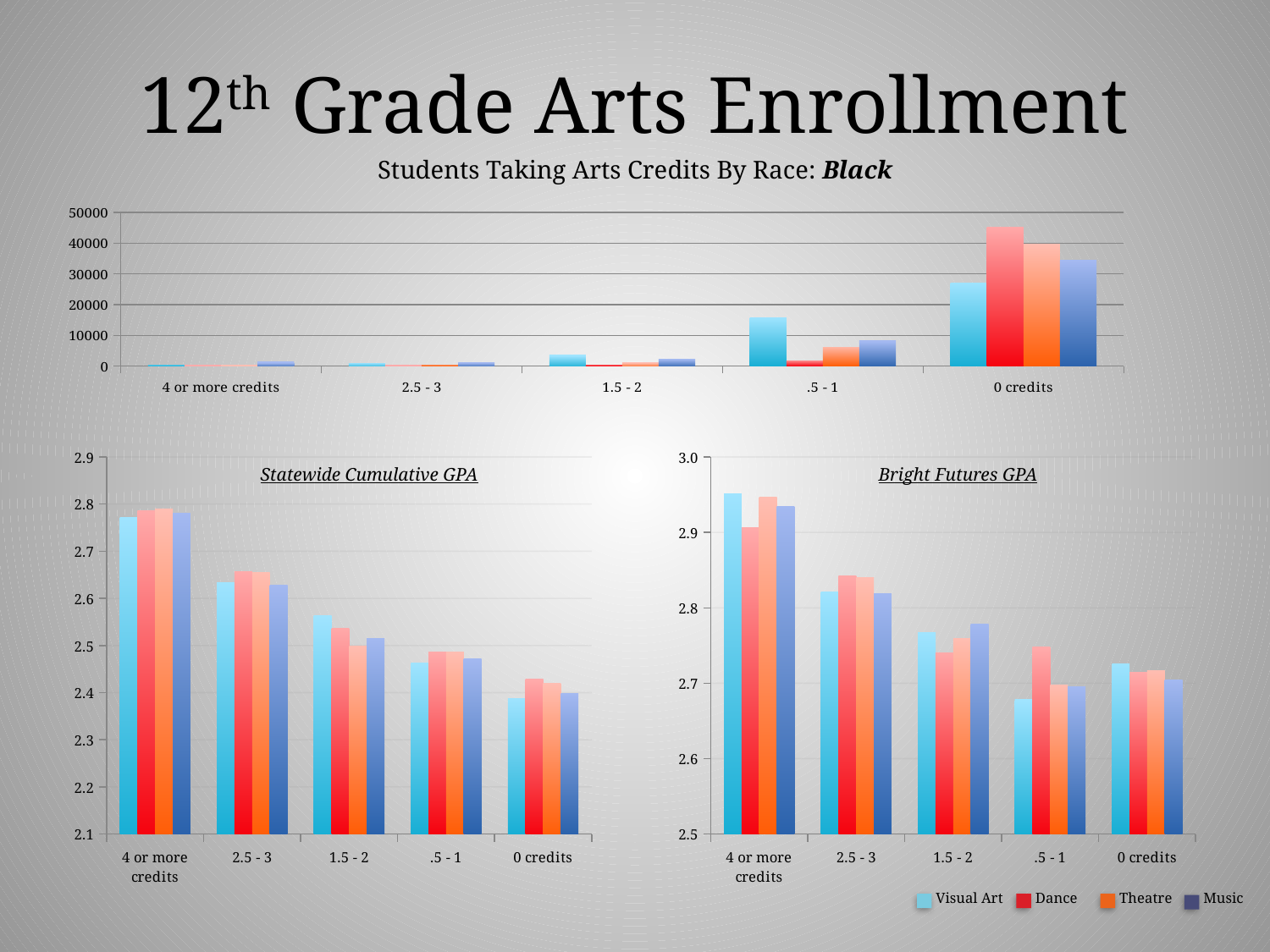
In the top chart 'Students Taking Arts Credits By Race: Black', which credit category has the highest bars? 0 credits What kind of chart is the top chart titled 'Students Taking Arts Credits By Race: Black'? bar chart In the 'Statewide Cumulative GPA' chart, is the value for Visual Art at 4 or more credits greater or less than 2.7? greater How many series does the legend list? 4 How many credit categories are shown on the x axis of the 'Statewide Cumulative GPA' chart? 5 In the top chart 'Students Taking Arts Credits By Race: Black', is the value for Dance at 0 credits greater or less than 40000? greater In the 'Bright Futures GPA' chart, which is larger at 4 or more credits: Visual Art or Dance? Visual Art In the top chart 'Students Taking Arts Credits By Race: Black', is the value for Visual Art at 0 credits greater or less than 30000? less In the 'Statewide Cumulative GPA' chart, which credit category has the lowest bars? 0 credits In the 'Statewide Cumulative GPA' chart, do the values rise or fall as you move from '4 or more credits' to '0 credits'? fall